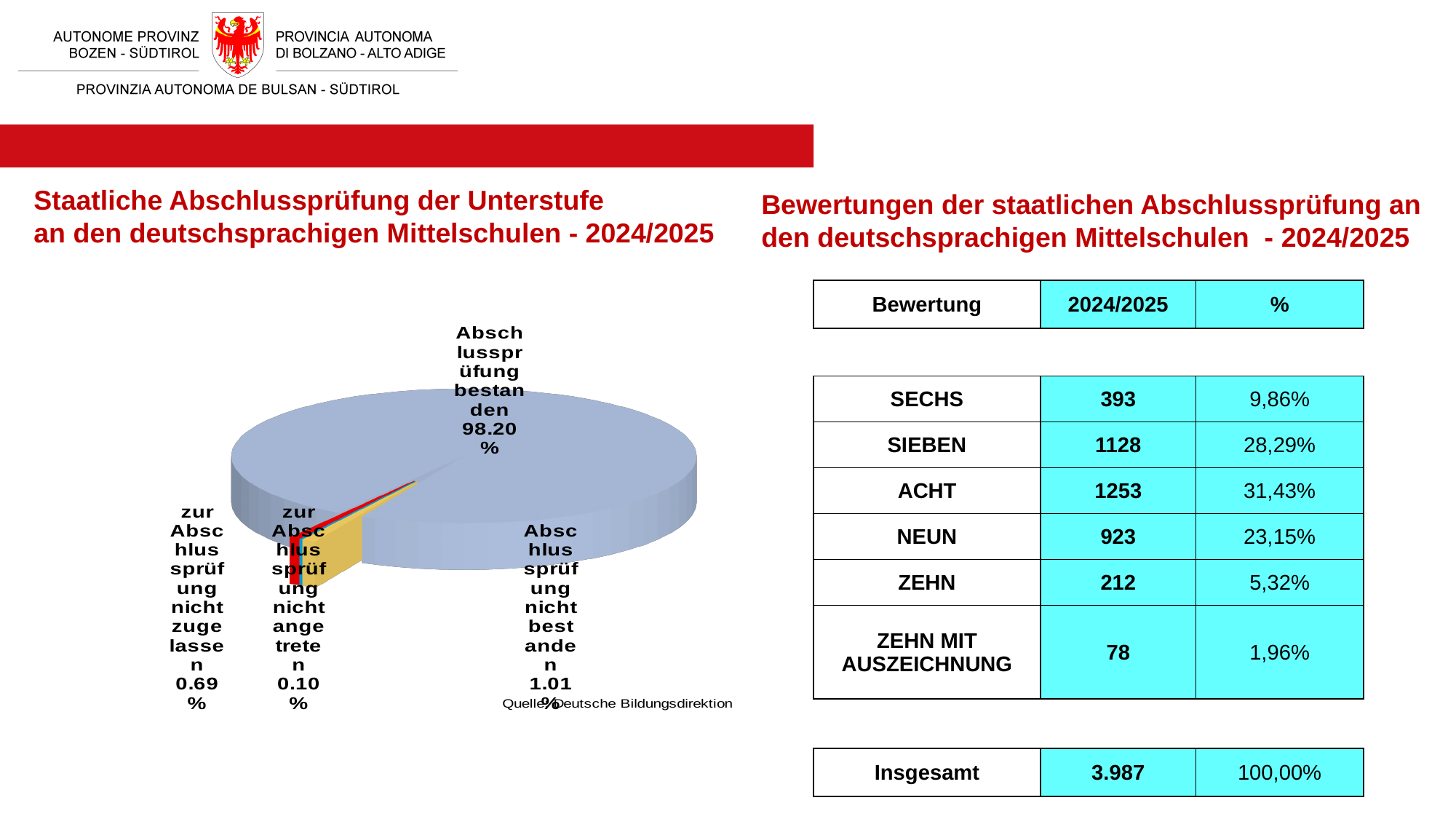
What share of the pie is labelled "Abschlussprüfung bestanden"? 98.20% What share of the pie is labelled "Abschlussprüfung nicht bestanden"? 1.01% What is the difference between the "zur Abschlussprüfung nicht zugelassen" share and the "zur Abschlussprüfung nicht angetreten" share in the pie chart? 0.59% Which is larger in the pie chart: "Abschlussprüfung nicht bestanden" or "zur Abschlussprüfung nicht zugelassen"? Abschlussprüfung nicht bestanden What kind of chart is shown on the slide? Pie chart What share of the pie is labelled "zur Abschlussprüfung nicht angetreten"? 0.10% Which slice of the pie chart is the smallest? zur Abschlussprüfung nicht angetreten What is the difference between the "Abschlussprüfung nicht bestanden" share and the "zur Abschlussprüfung nicht zugelassen" share in the pie chart? 0.32% What is the title above the pie chart? Staatliche Abschlussprüfung der Unterstufe an den deutschsprachigen Mittelschulen - 2024/2025 Which slice of the pie chart is the largest? Abschlussprüfung bestanden How many slices does the pie chart have? 4